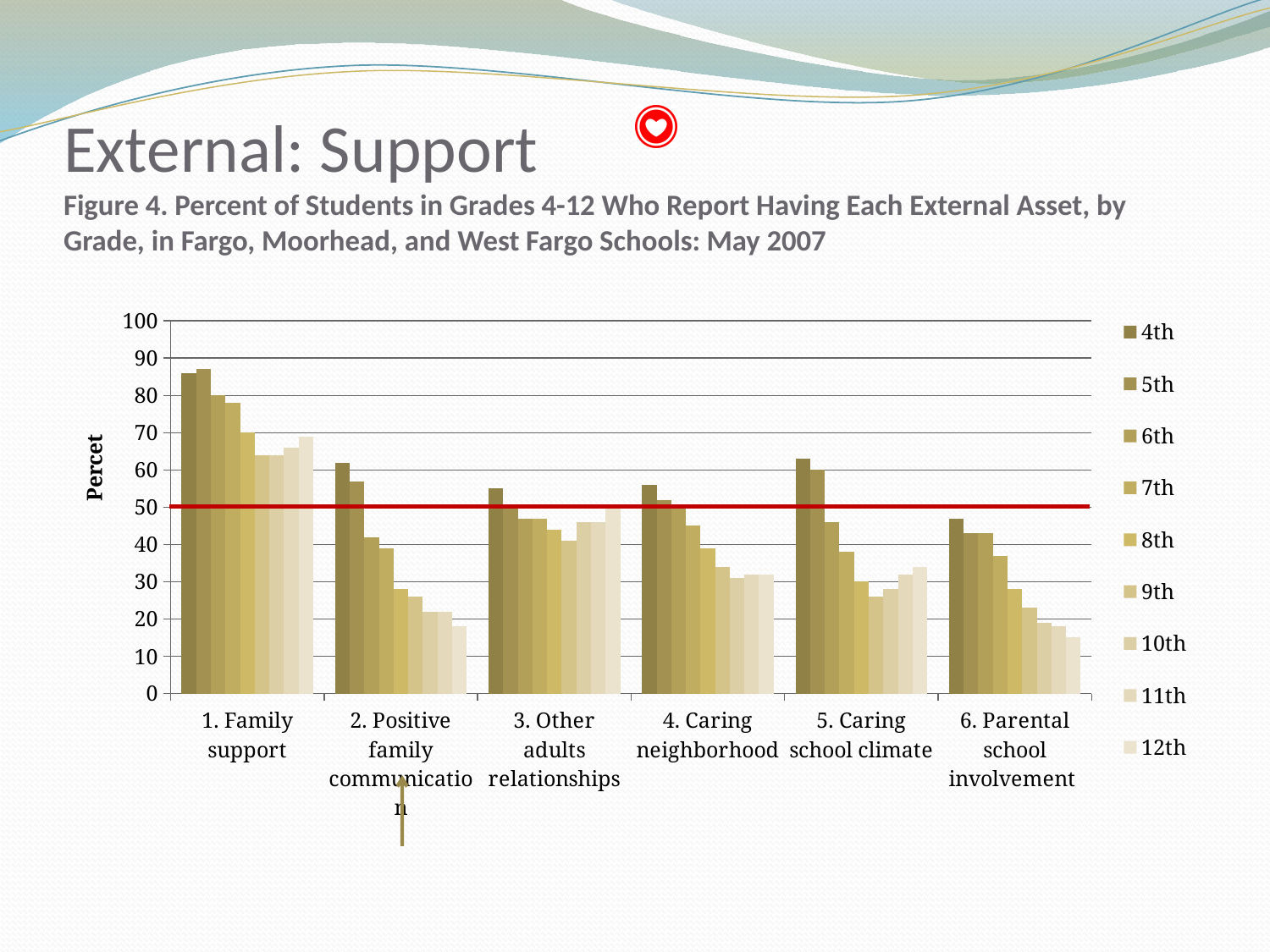
At what value on the y axis is the red horizontal line drawn? 50 What kind of chart is shown on the slide? bar chart Which category has the lowest value for 12th grade? 6. Parental school involvement Is the value for 4th grade in '5. Caring school climate' greater or less than 60? greater Is the value for 12th grade in '2. Positive family communication' greater or less than 20? less Is the value for 4th grade in '1. Family support' greater or less than 80? greater How many external asset categories are shown along the x axis? 6 Which is larger: the 4th grade value for '1. Family support' or the 4th grade value for '6. Parental school involvement'? 1. Family support Within '2. Positive family communication', do the values rise or fall from 4th grade to 12th grade? fall Which category has the highest value for 4th grade? 1. Family support How many series (grades) does the legend list? 9